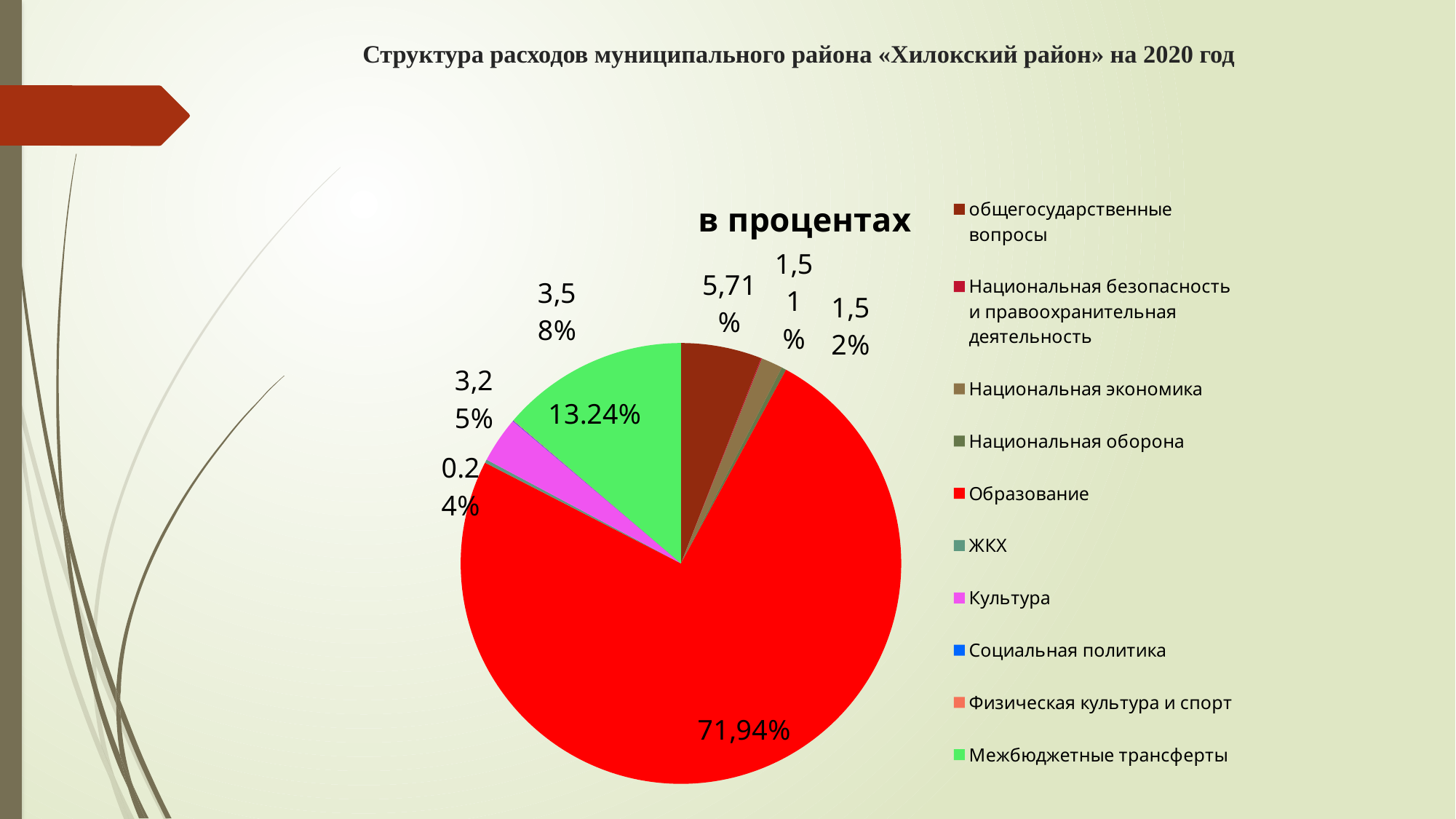
Which category has the largest slice of the pie? Образование What value is shown for Культура? 3,25% What value is shown for общегосударственные вопросы? 5,71% What share of the pie does Межбюджетные трансферты have? 13.24% Which is larger, Образование or Межбюджетные трансферты? Образование How many entries does the legend list? 10 What value is shown for ЖКХ? 0.24% What share of the pie does Образование have? 71,94% What is the difference between the shares of Образование and общегосударственные вопросы? 66,23% Which is larger, общегосударственные вопросы or Культура? общегосударственные вопросы What is the title of the chart? в процентах What kind of chart is shown on the slide? Pie chart